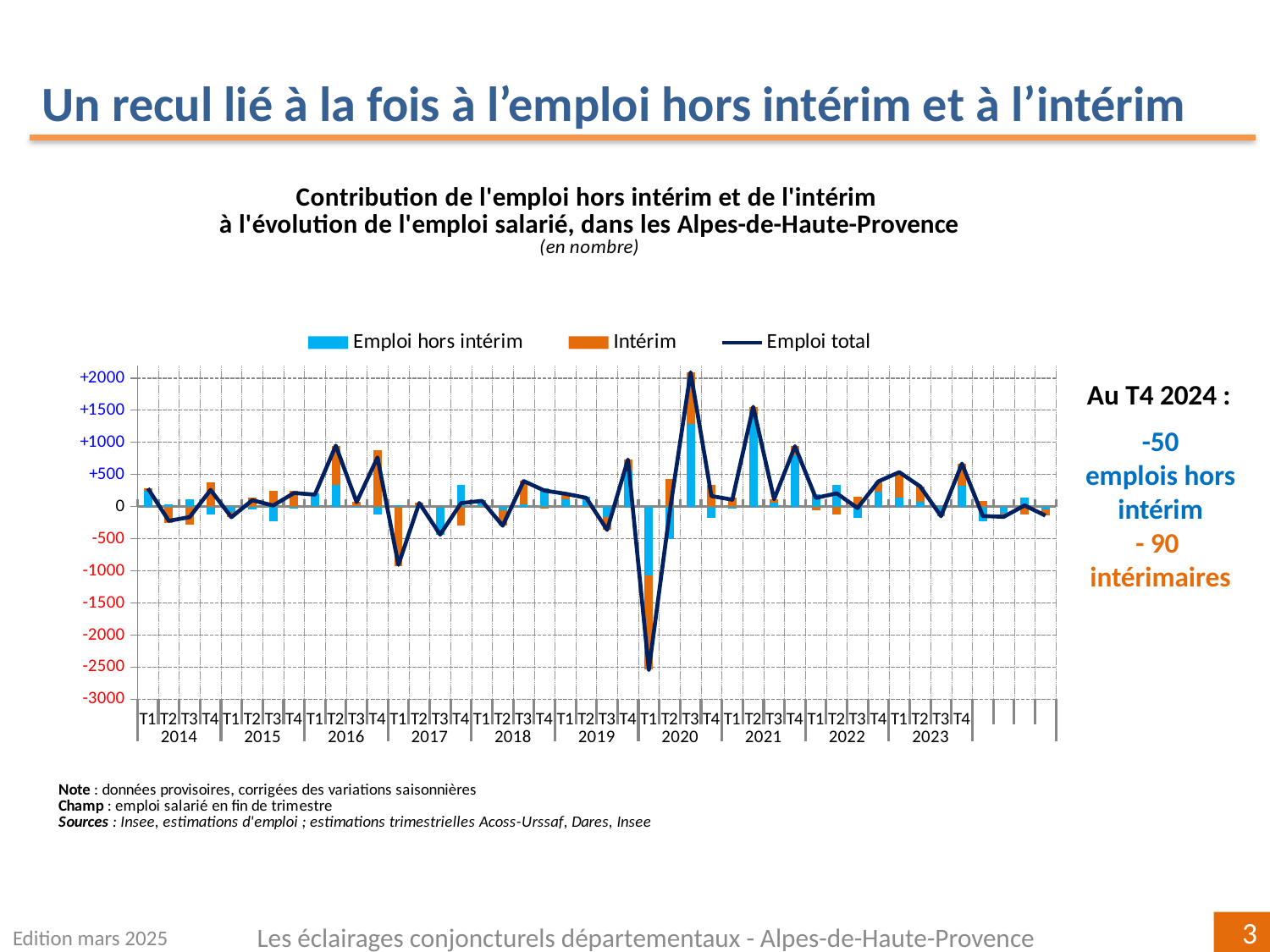
Which colour represents the Intérim series in the chart? Orange Which is larger: the Emploi total value at T3 2020 or at T2 2021? T3 2020 What kind of chart is shown on the slide? Combined bar and line chart What is the difference between the T4 2024 values for Emploi hors intérim (-50) and Intérim (-90)? 40 How many series does the chart legend list? 3 According to the annotation, what is the value for Intérim at T4 2024? -90 In which quarter does the Emploi total line reach its lowest point? T1 2020 Does the Emploi total line rise or fall between T1 2020 and T3 2020? rise Is the value of Emploi total at T1 2020 greater or less than -2000? less In which quarter does the Emploi total line reach its highest point? T3 2020 According to the annotation, what is the value for Emploi hors intérim at T4 2024? -50 Is the value of Emploi total at T3 2020 greater or less than +1500? greater